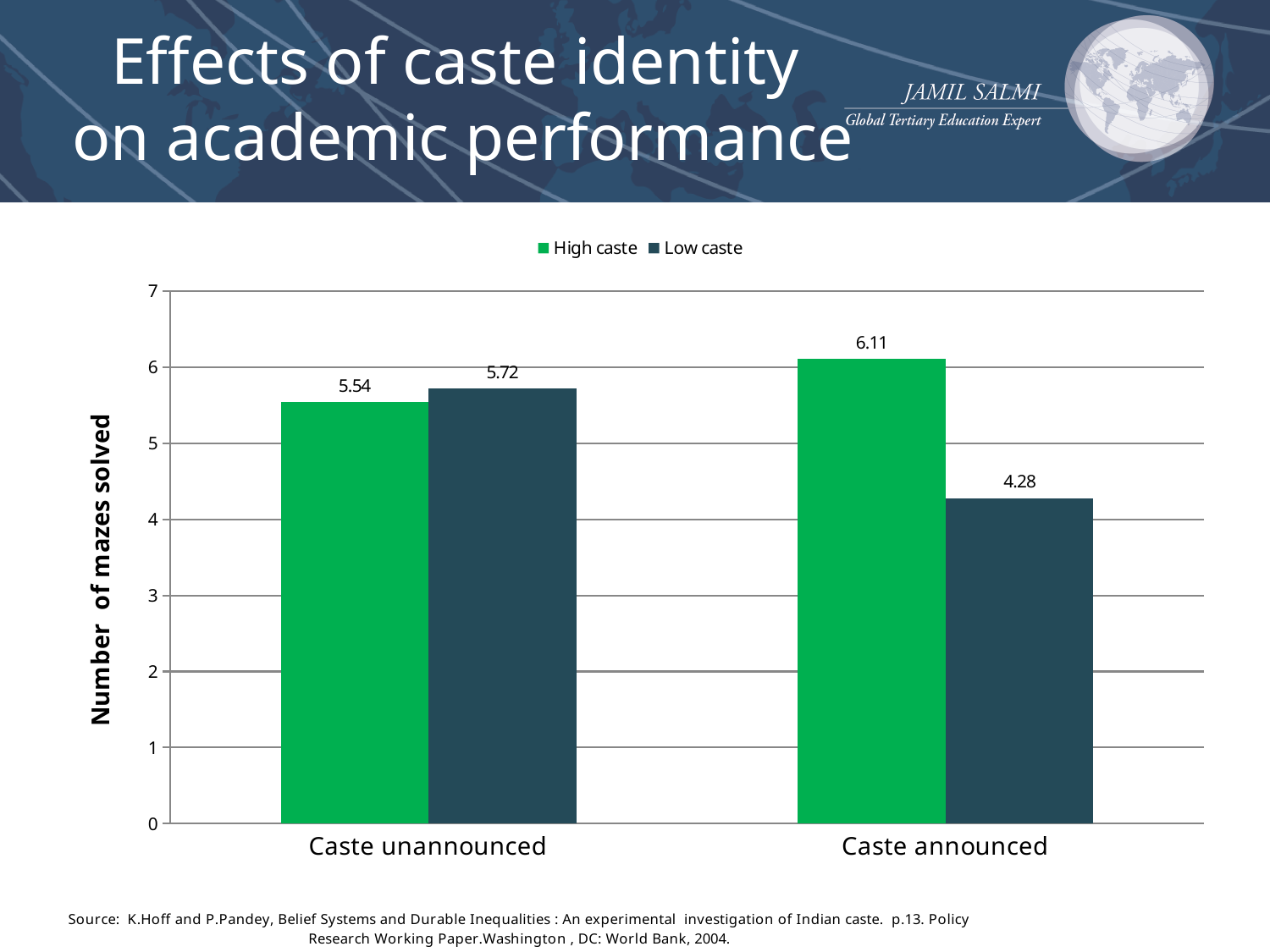
How many series does the legend list? 2 What is the value for Low caste in the Caste unannounced condition? 5.72 What kind of chart is shown on the slide? Bar chart Which bar has the highest value on the chart? High caste, Caste announced How many categories are shown on the x axis? 2 What is the difference between the High caste and Low caste values in the Caste announced condition? 1.83 Is the value for High caste in the Caste announced condition greater or less than 6? greater In the Caste unannounced condition, which group solved more mazes, High caste or Low caste? Low caste What is the number of mazes solved by the Low caste group when caste is announced? 4.28 Which bar has the lowest value on the chart? Low caste, Caste announced What is the label of the vertical axis? Number of mazes solved What is the number of mazes solved by the High caste group when caste is unannounced? 5.54